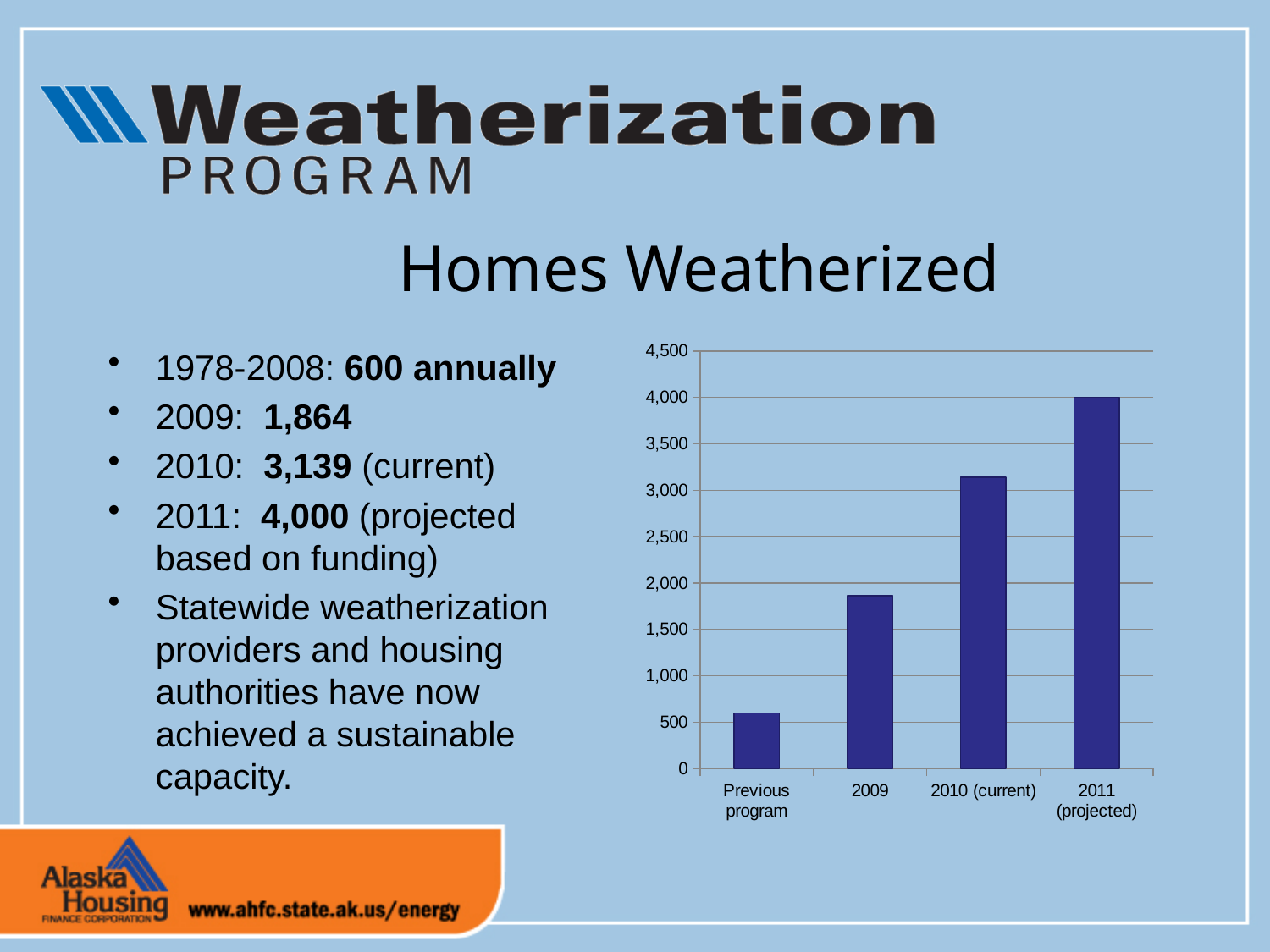
Which is larger, the bar for 2009 or the bar for 2010 (current)? 2010 (current) Is the value for 2009 greater or less than 1,500? greater What kind of chart is shown on the slide? bar chart Which category has the lowest bar in the chart? Previous program Is the value for Previous program greater or less than 1,000? less Do the bar values rise or fall from left to right along the x axis? rise Is the value for 2010 (current) greater or less than 3,500? less How many categories are shown on the x axis of the chart? 4 Which category has the highest bar in the chart? 2011 (projected) What colour are the bars in the chart? dark blue What value does the bar for 2011 (projected) reach on the axis? 4,000